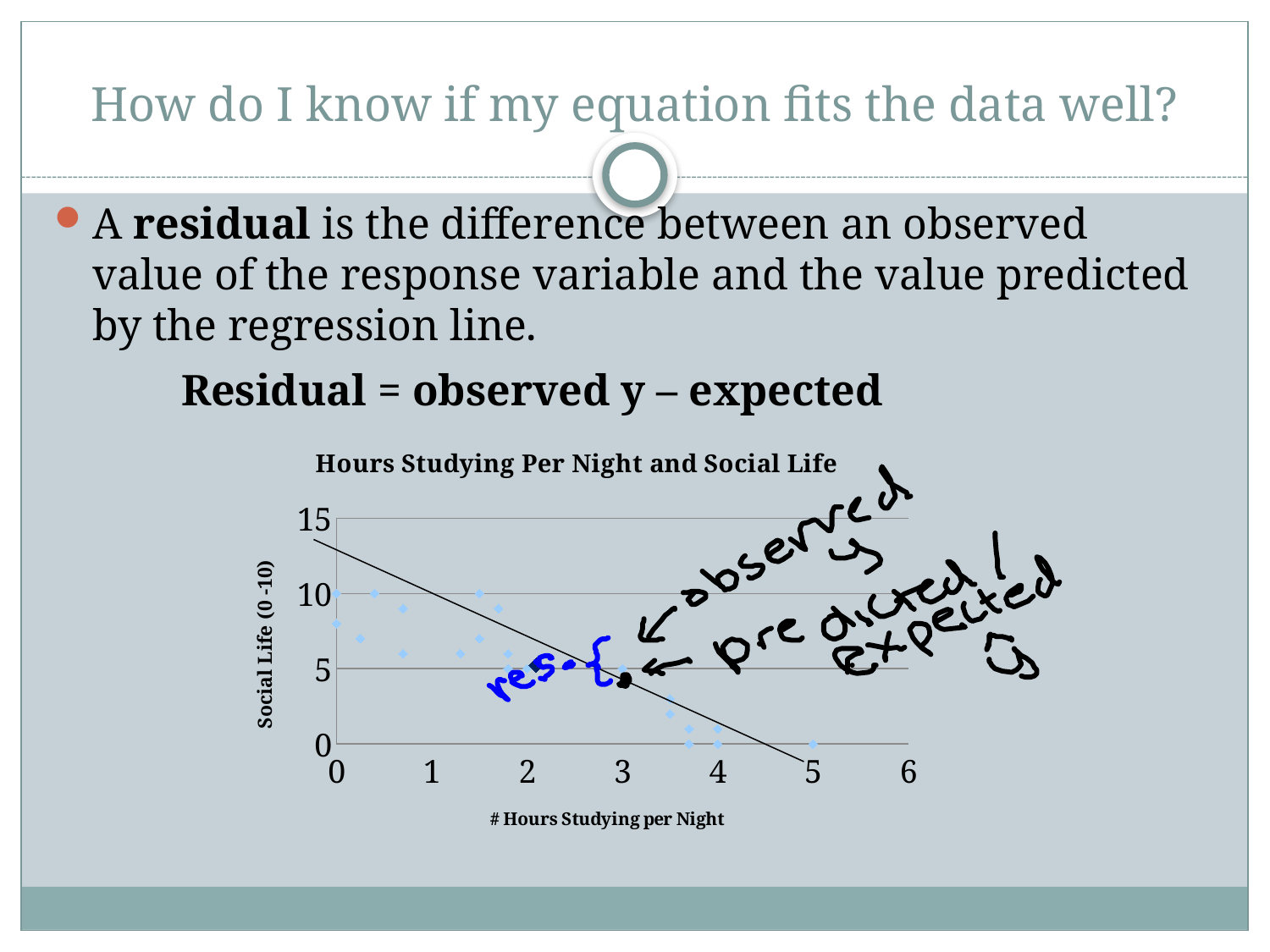
What is the title of the chart? Hours Studying Per Night and Social Life As the number of hours studying per night increases, does social life rise or fall according to the chart? fall Does the regression line on the chart slope upward or downward from left to right? downward Is the plotted point at 5 hours studying greater or less than 5 on the social life scale? less What kind of chart is shown on the slide? scatter plot Is the value of the regression line at 0 hours studying greater or less than 10? greater What is the label of the x axis of the chart? # Hours Studying per Night Is the highest plotted point at 0 hours studying greater or less than 5 on the social life scale? greater